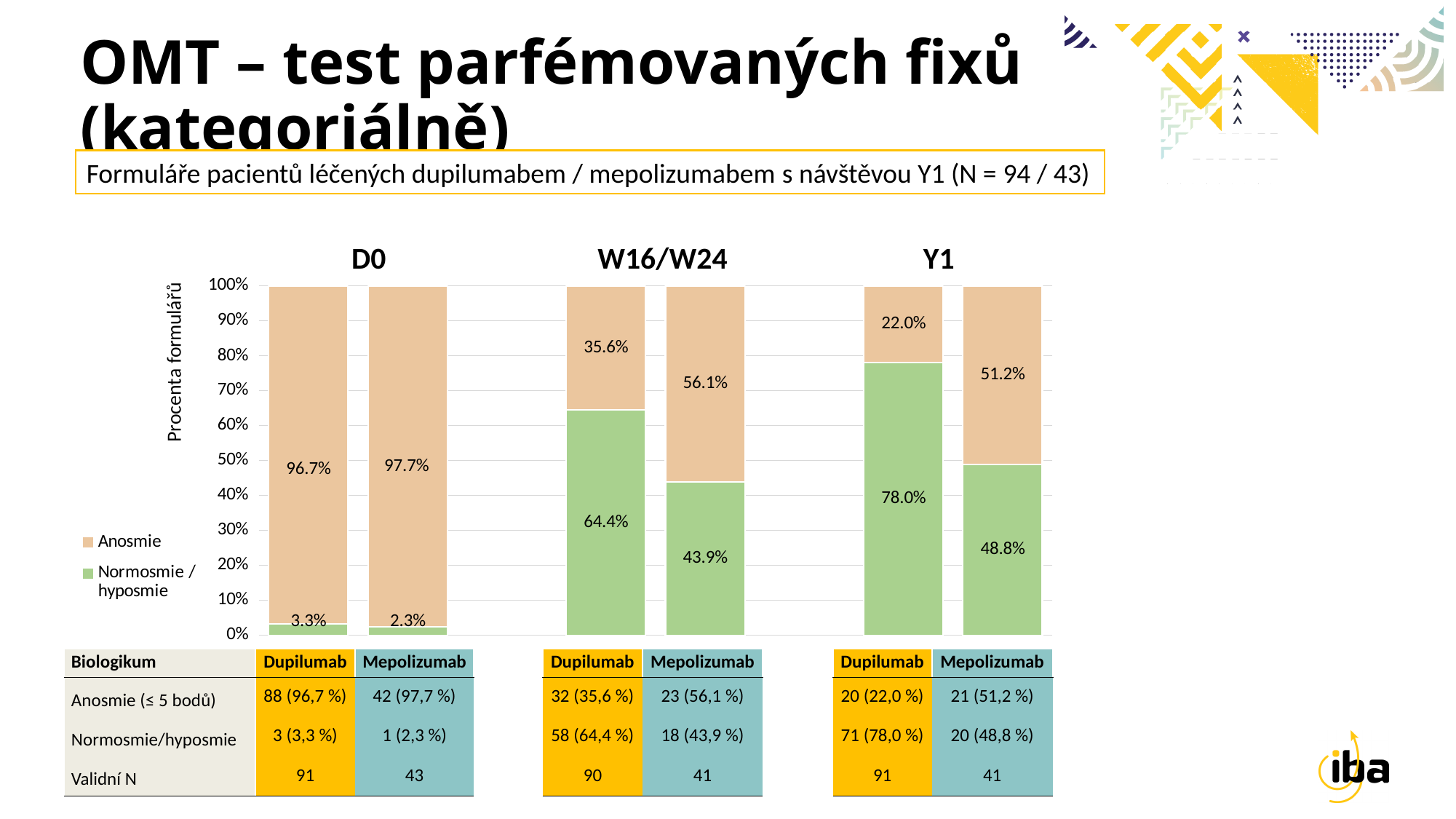
How does the Normosmie / hyposmie percentage for Dupilumab change from D0 to Y1? It rises What is the Normosmie / hyposmie percentage for Mepolizumab at D0? 2.3% What is the Normosmie / hyposmie percentage for Mepolizumab at W16/W24? 43.9% What is the difference between the Anosmie percentages for Mepolizumab and Dupilumab at W16/W24? 20.5% What is the label of the vertical axis? Procenta formulářů How many series does the chart legend list? 2 Which bar has the highest Normosmie / hyposmie percentage? Dupilumab at Y1 What type of chart is shown on the slide? stacked bar chart What is the Anosmie percentage for Dupilumab at Y1? 22.0% What is the Anosmie percentage for Dupilumab at D0? 96.7% Which bar has the lowest Normosmie / hyposmie percentage? Mepolizumab at D0 At Y1, which has the larger Anosmie percentage, Dupilumab or Mepolizumab? Mepolizumab